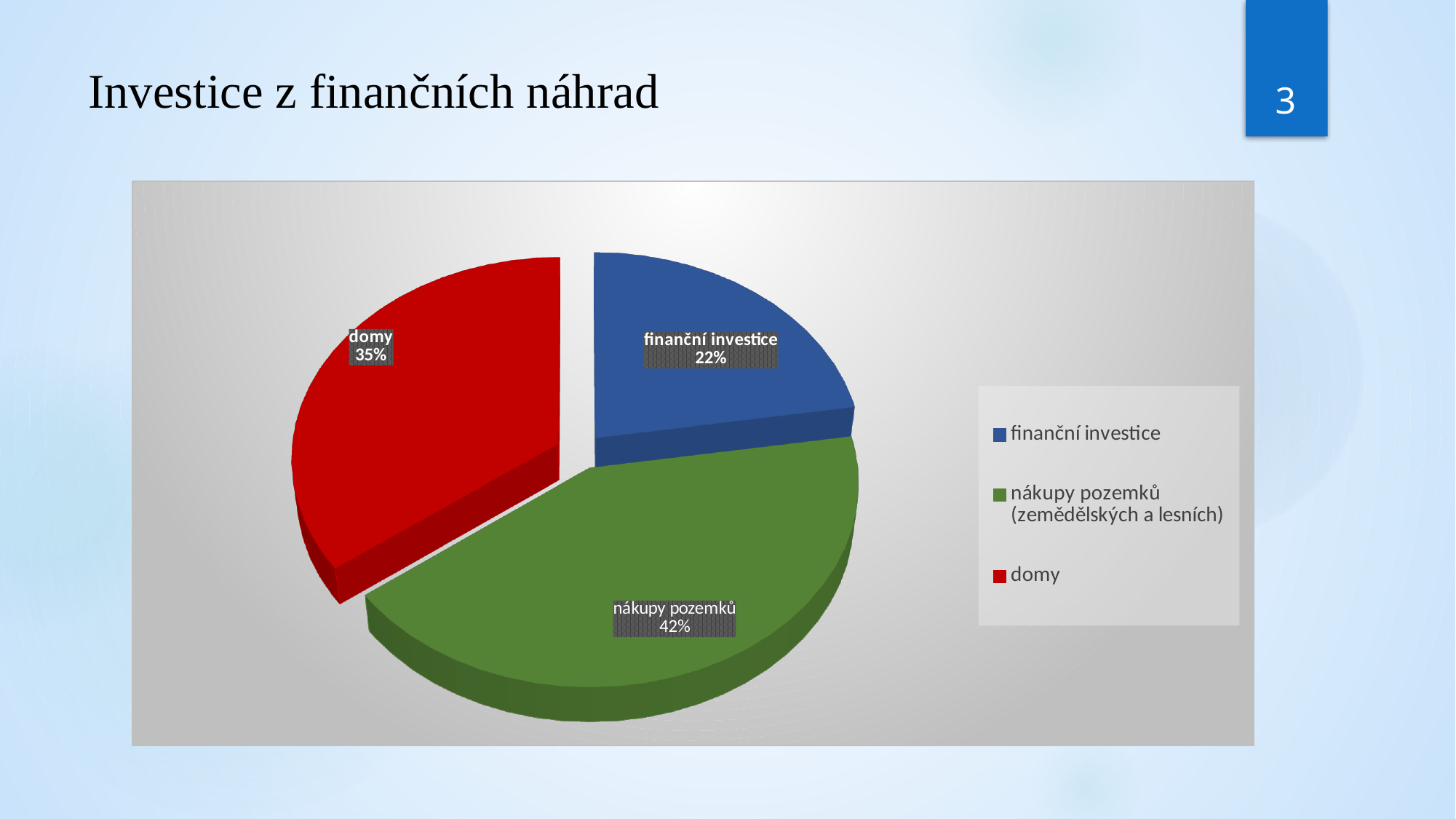
What share of the pie does 'domy' have? 35% Which category has the smallest slice of the pie? finanční investice How many entries does the legend list? 3 Which category has the largest slice of the pie? nákupy pozemků What kind of chart is shown on the slide? pie chart What colour is the slice for 'domy'? red What share of the pie does 'nákupy pozemků' have? 42% How many slices does the pie chart have? 3 What is the difference in percentage points between 'domy' and 'finanční investice'? 13 What is the difference in percentage points between 'nákupy pozemků' and 'domy'? 7 Which is larger, the share for 'domy' or the share for 'finanční investice'? domy What share of the pie does 'finanční investice' have? 22%